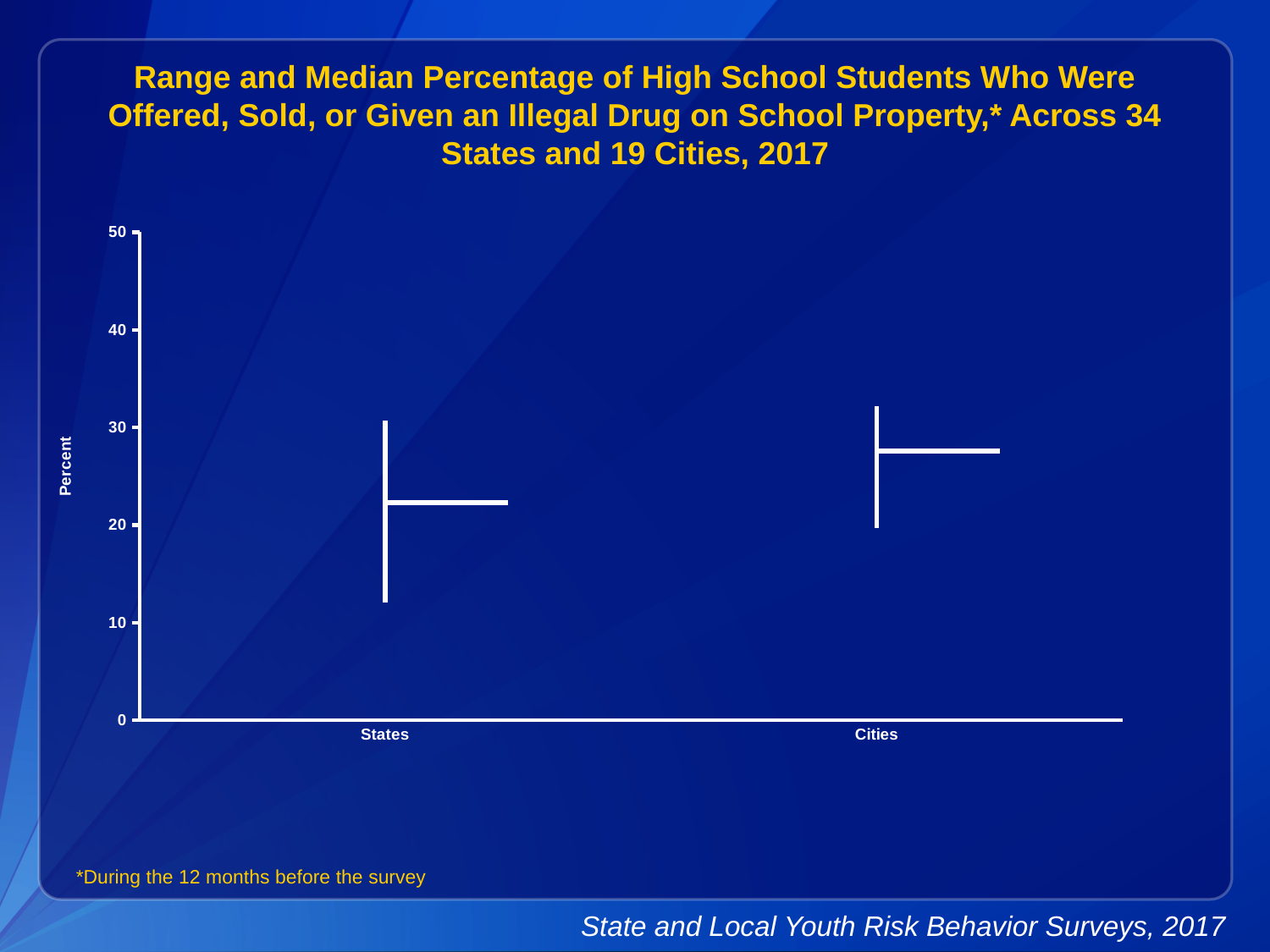
What are the two categories shown on the x axis? States and Cities How many categories are shown on the x axis of the chart? 2 Is the median value for Cities greater or less than 20? greater Is the lowest value in the range for States greater or less than 20? less Is the median value for Cities greater or less than 30? less Which category has the lower bottom of its range, States or Cities? States What is the highest value shown on the y axis? 50 Which category has the higher median percentage, States or Cities? Cities What is the label of the y axis? Percent